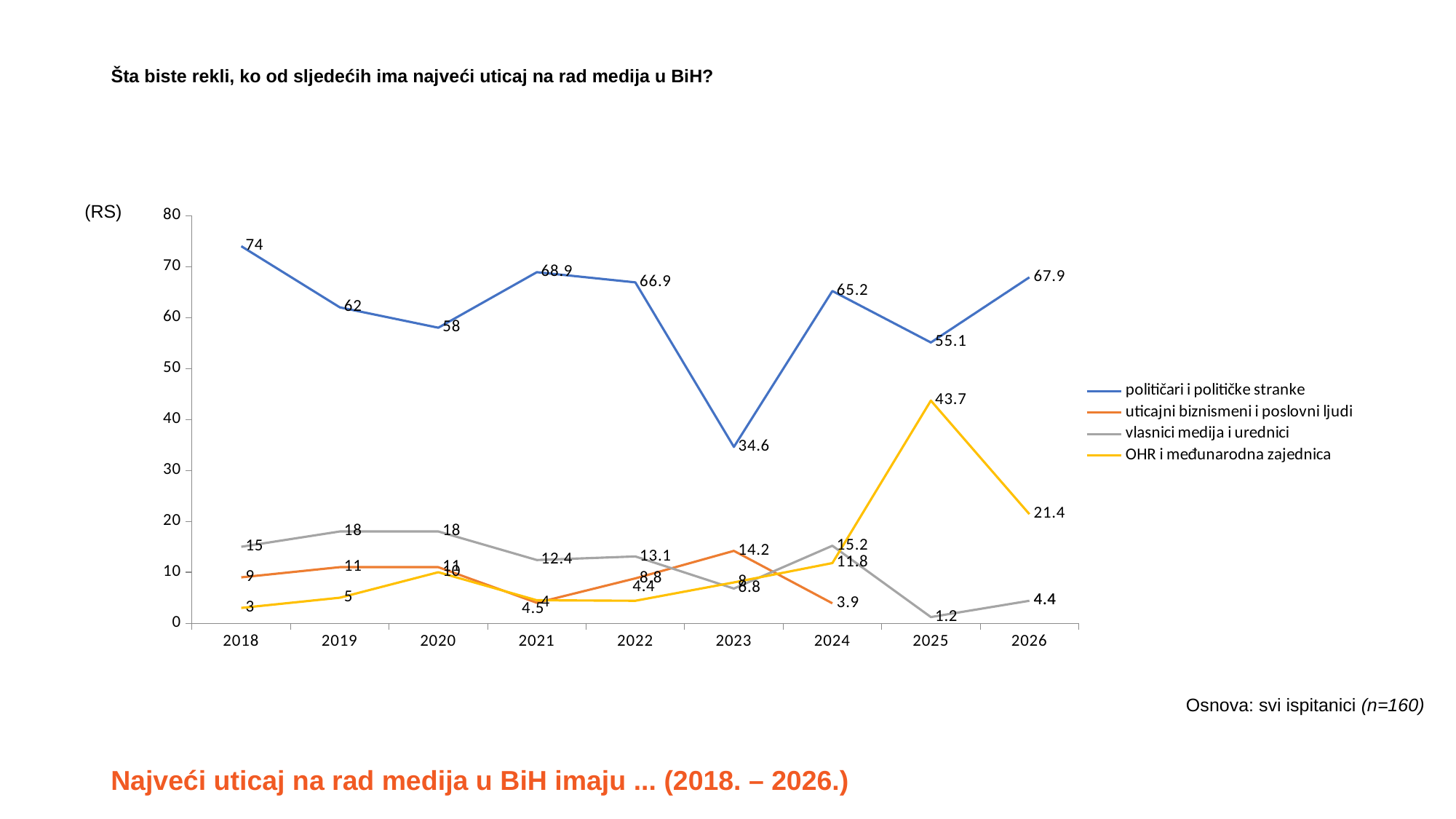
What is the value for vlasnici medija i urednici in 2025? 1.2 What kind of chart is shown on the slide? line chart In which year does the političari i političke stranke line reach its lowest value? 2023 In 2025, which is larger: OHR i međunarodna zajednica or vlasnici medija i urednici? OHR i međunarodna zajednica Does the OHR i međunarodna zajednica line rise or fall from 2025 to 2026? fall How many years are shown on the x axis? 9 In which year does the političari i političke stranke line reach its highest value? 2018 How many series does the legend list? 4 What is the value for političari i političke stranke in 2023? 34.6 What is the value for OHR i međunarodna zajednica in 2025? 43.7 What is the value for političari i političke stranke in 2018? 74 What is the difference between the političari i političke stranke values in 2018 and 2019? 12